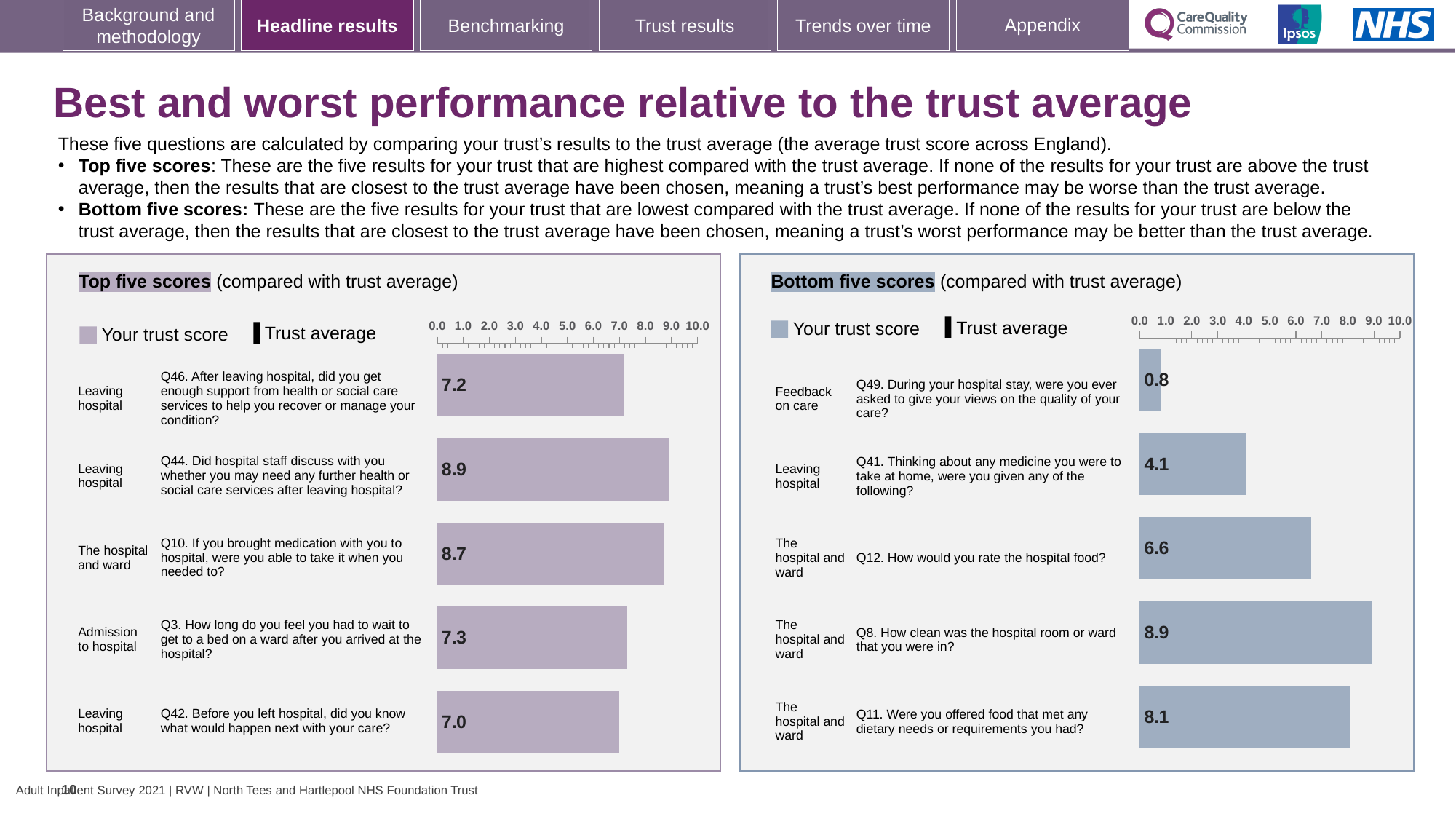
In the Top five scores chart, what is the trust score for Q46 (support from health or social care services after leaving hospital)? 7.2 In the Bottom five scores chart, what is the trust score for Q49 (asked to give views on quality of care)? 0.8 In the Bottom five scores chart, what is the difference between the trust scores for Q8 and Q41? 4.8 What type of chart is used in the Top five scores panel? Bar chart In the Top five scores chart, which question has the highest trust score? Q44 How many questions are shown in the Bottom five scores chart? 5 In the Bottom five scores chart, what is the trust score for Q12 (rating of hospital food)? 6.6 In the Bottom five scores chart, which question has the lowest trust score? Q49 In the Bottom five scores chart, which has the larger trust score, Q11 or Q12? Q11 How many entries does the legend of the Top five scores chart list? 2 In the Top five scores chart, what is the trust score for Q44 (staff discussing further health or social care services)? 8.9 In the Top five scores chart, what is the difference between the trust scores for Q10 and Q42? 1.7